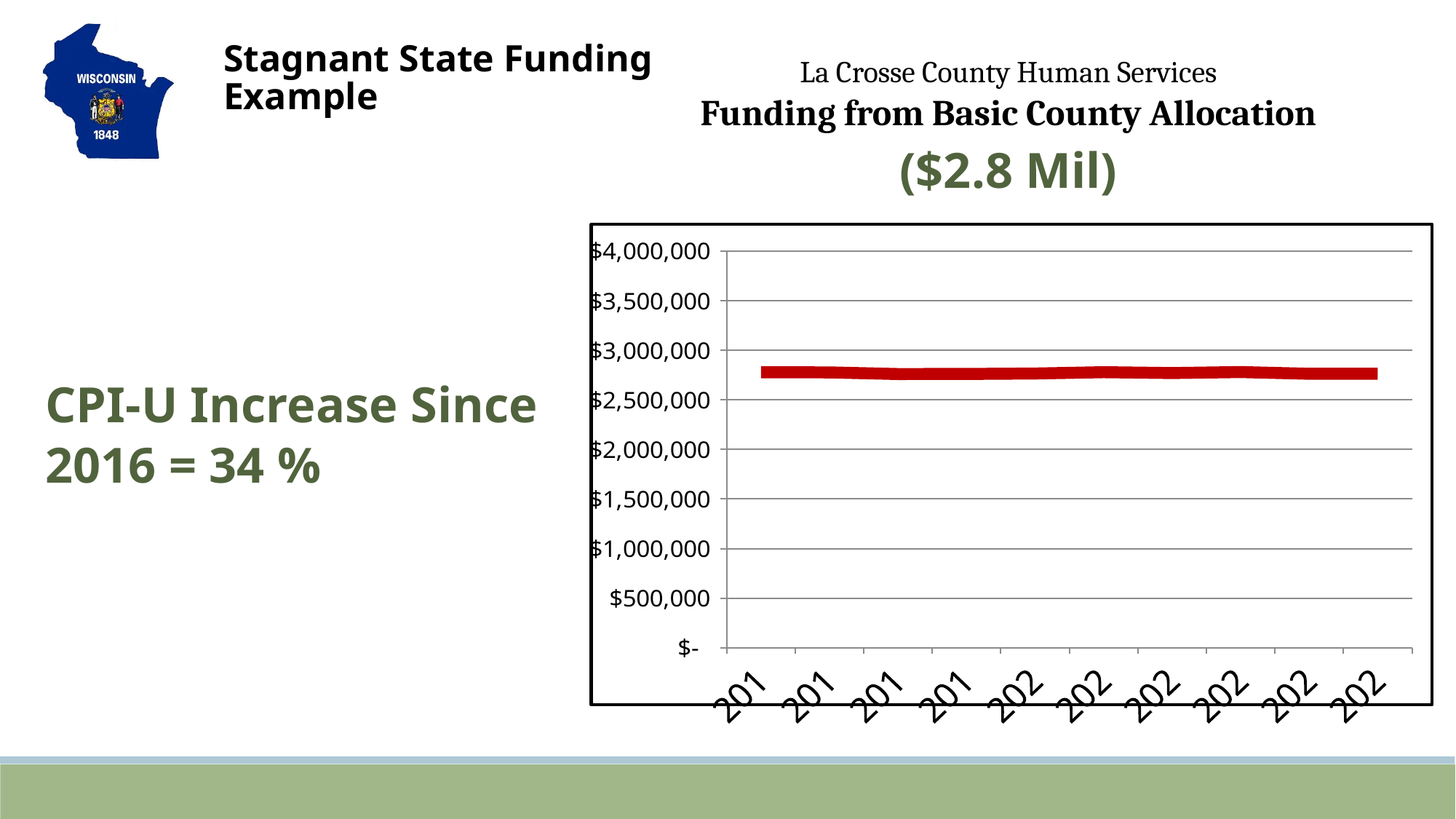
Are all the plotted values in the chart greater or less than $3,500,000? less How many lines (series) are plotted in the chart? 1 Do the values in the chart rise, fall, or stay roughly flat across the x axis? Stay roughly flat Is the value for the first point on the chart greater or less than $2,500,000? greater How many data points are plotted along the x axis of the chart? 10 What is the highest value shown on the chart's y axis? $4,000,000 What kind of chart is shown on the slide? Line chart Is the value for the last point on the chart greater or less than $3,000,000? less What colour is the line plotted in the chart? Red What is the title of the chart? Funding from Basic County Allocation